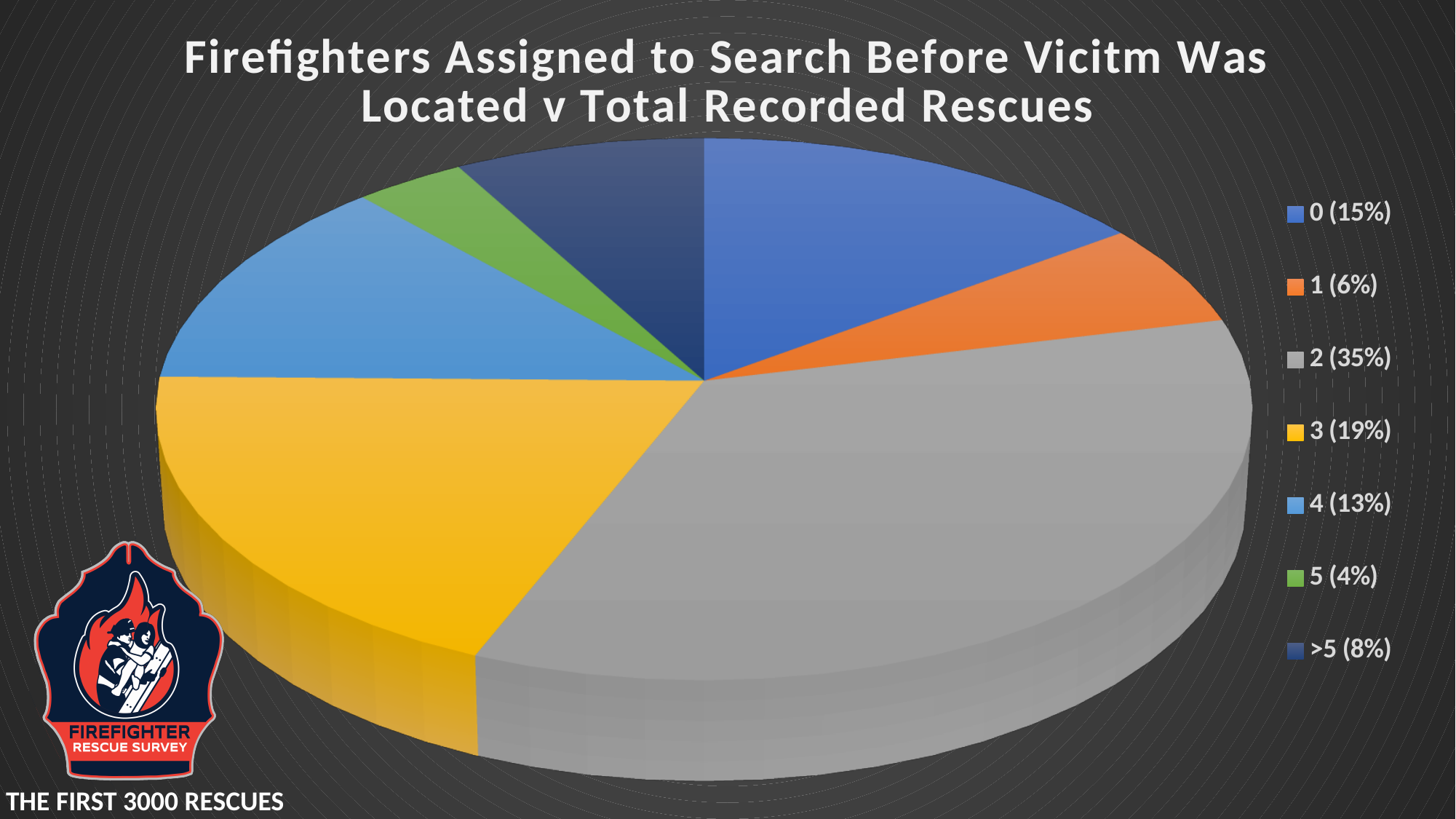
What is the difference in percentage points between the "3" category and the "4" category? 6 What percentage is shown for the category ">5" firefighters assigned to search? 8% What kind of chart is shown on the slide? Pie chart What is the combined percentage of the "0" and "1" categories? 21% How many categories does the pie chart show? 7 What is the title of the chart? Firefighters Assigned to Search Before Vicitm Was Located v Total Recorded Rescues Which category has the smallest share of the pie? 5 (4%) What colour is the slice for the "3 (19%)" category? Yellow Which category has the largest share of the pie? 2 (35%) What share of the pie does the category "2" firefighters assigned to search represent? 35% What percentage is shown for the category "0" firefighters assigned to search? 15% Which is larger, the share for "1" firefighters or the share for "5" firefighters? 1 (6%)